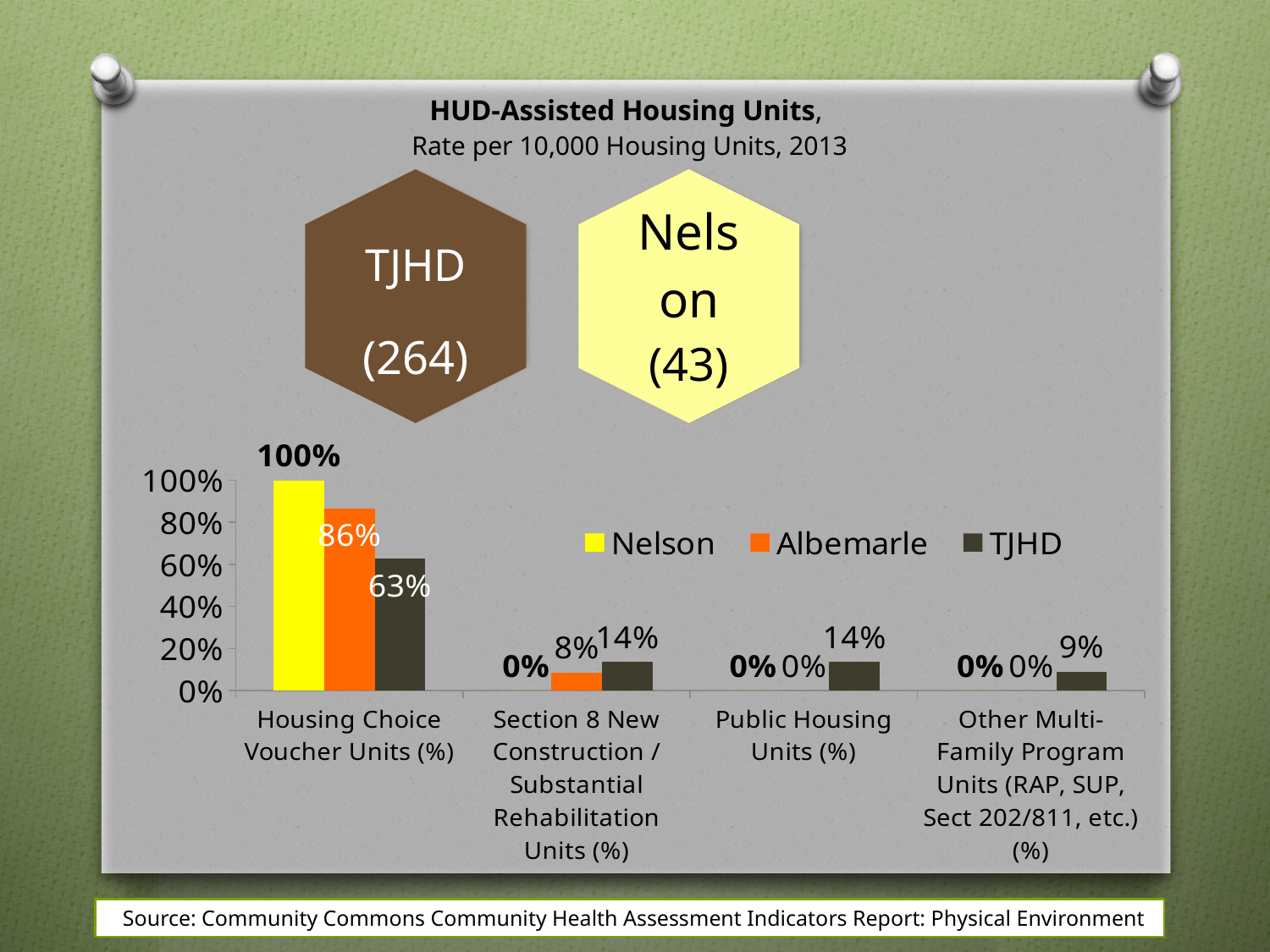
Which series has the highest value in the Housing Choice Voucher Units (%) category? Nelson How many series does the legend list? 3 What is the value for TJHD in the Section 8 New Construction / Substantial Rehabilitation Units (%) category? 14% What is the value for Nelson in the Housing Choice Voucher Units (%) category? 100% What rate per 10,000 housing units is shown for Nelson in the hexagon above the chart? 43 Which series has the lowest value in the Public Housing Units (%) category? Nelson and Albemarle (both 0%) What is the value for Albemarle in the Housing Choice Voucher Units (%) category? 86% Is the TJHD value for Section 8 New Construction / Substantial Rehabilitation Units (%) larger or smaller than the Albemarle value in that category? larger What is the difference between the Albemarle and TJHD values in the Housing Choice Voucher Units (%) category? 23% What is the value for TJHD in the Other Multi-Family Program Units (RAP, SUP, Sect 202/811, etc.) (%) category? 9% What kind of chart is shown on the slide? bar chart How many categories are shown on the x axis of the chart? 4